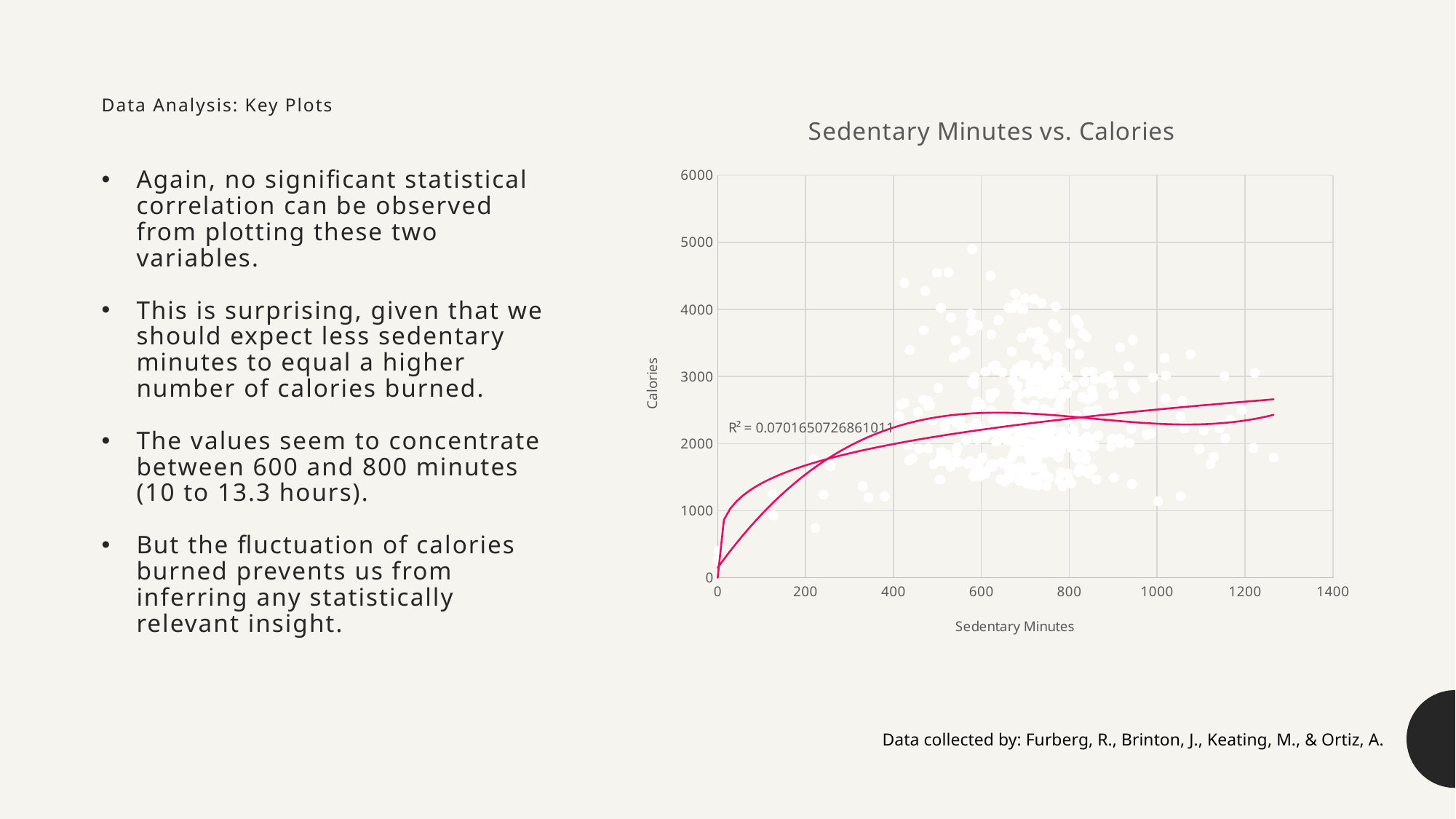
What label is shown on the vertical axis of the chart? Calories What is the highest tick value shown on the x axis of the chart? 1400 Do the trendlines on the chart rise or fall as sedentary minutes increase? rise What is the title of the chart? Sedentary Minutes vs. Calories What kind of chart is shown on the slide? Scatter chart Is the highest calorie value plotted on the chart greater or less than 4000? greater Is the lowest calorie value plotted on the chart greater or less than 1000? less What R² value is printed on the chart? 0.0701650726861011 What is the highest tick value shown on the y axis of the chart? 6000 Is the calorie value of the point with the most sedentary minutes (around 1260) greater or less than 2000? less